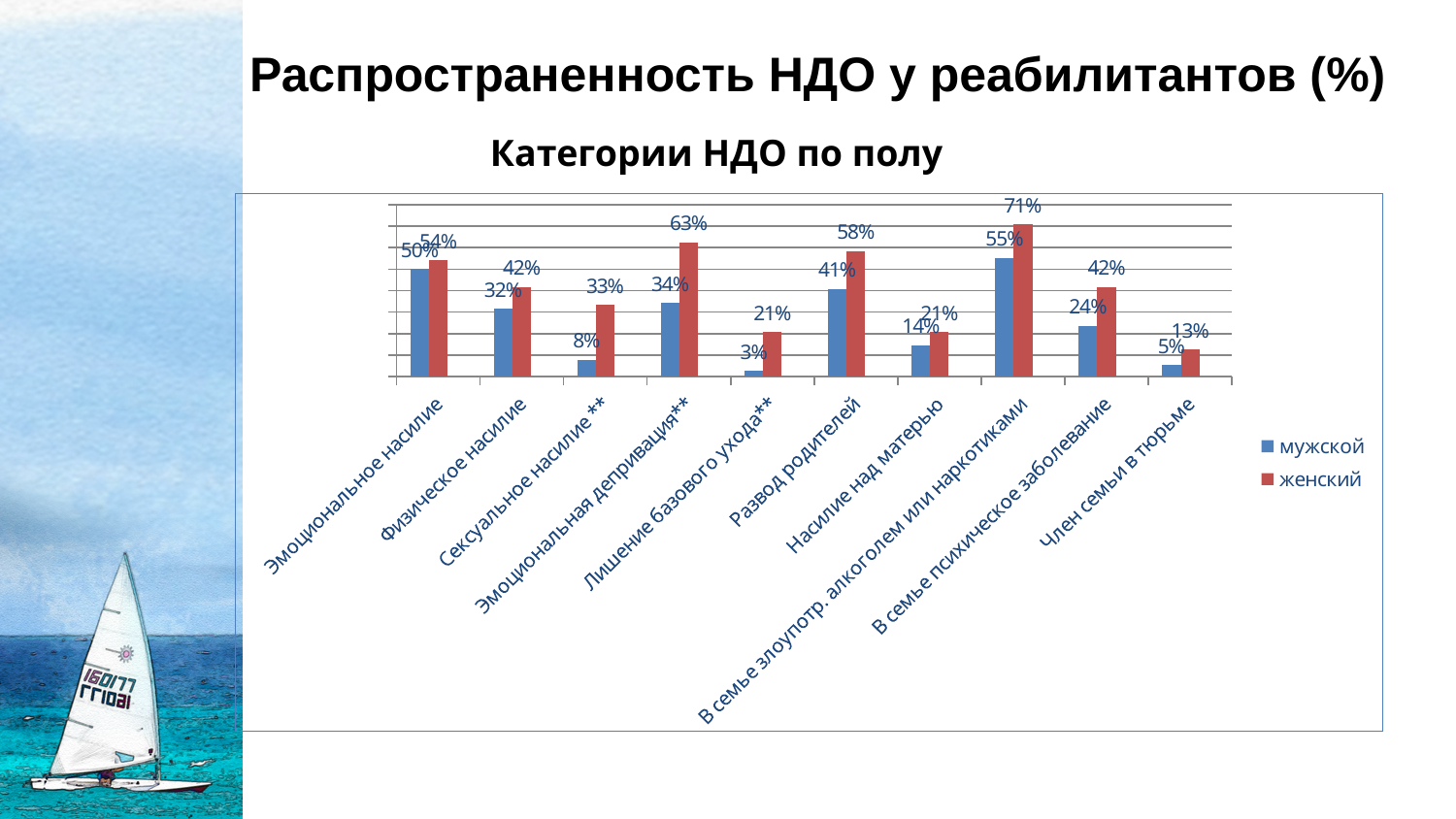
What kind of chart is shown on the slide? bar chart Which category has the lowest value for мужской? Лишение базового ухода** What is the difference between the женский and мужской values for Сексуальное насилие **? 25% How many categories are shown on the x axis? 10 Which colour represents the series женский in the chart? red What is the value for мужской in the category Сексуальное насилие **? 8% What is the value for женский in the category Эмоциональная депривация**? 63% Which is larger for Физическое насилие: the мужской value or the женский value? женский What is the value for женский in the category Развод родителей? 58% What is the difference between the женский and мужской values for В семье злоупотр. алкоголем или наркотиками? 16% Which category has the highest value for женский? В семье злоупотр. алкоголем или наркотиками How many series does the legend list? 2